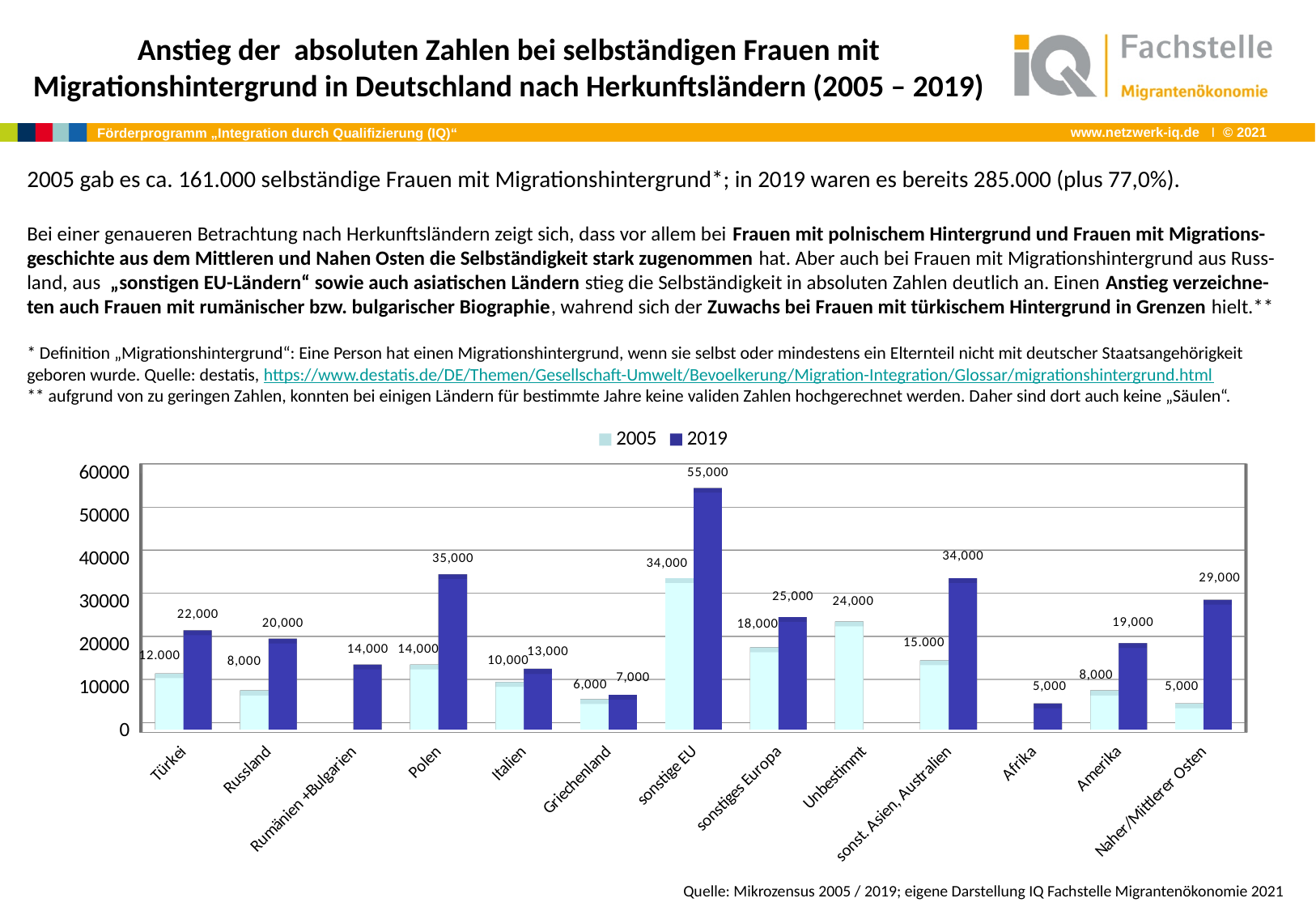
What is the 2019 value for Amerika? 19,000 Which category has the lowest 2019 value? Afrika What kind of chart is shown on the slide? Bar chart Which category has the highest 2019 value? sonstige EU What is the 2005 value for sonstige EU? 34,000 How many categories are shown on the x axis? 13 What is the difference between the 2019 and 2005 values for Polen? 21,000 What is the 2019 value for Polen? 35,000 Which is larger in 2019: Türkei or Russland? Türkei How many series does the legend list? 2 By how much did the value for Naher/Mittlerer Osten increase from 2005 to 2019? 24,000 What is the 2005 value for Unbestimmt? 24,000